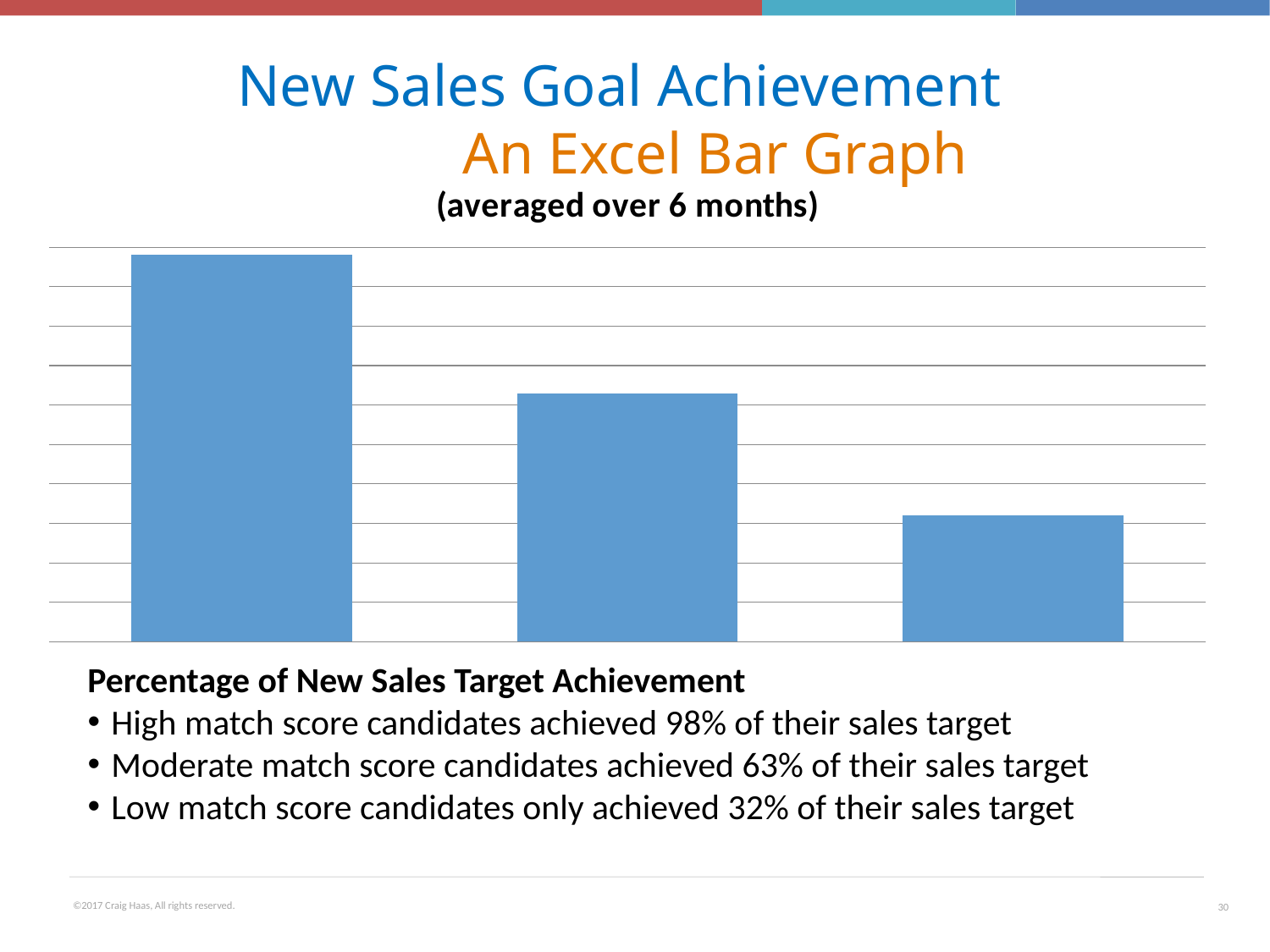
Over what period does the slide say the chart values are averaged? 6 months How many bars are plotted in the chart? 3 Which is taller, the left bar or the middle bar? the left bar According to the slide text, what percentage of their sales target did low match score candidates achieve? 32% What kind of chart is shown on the slide? bar chart Do the bar heights rise or fall from left to right across the chart? fall Which is taller, the middle bar or the right bar? the middle bar What is the main title shown above the chart? New Sales Goal Achievement According to the slide text, what percentage of their sales target did high match score candidates achieve? 98% Which bar is the shortest in the chart: the left, middle, or right one? right According to the slide text, what percentage of their sales target did moderate match score candidates achieve? 63% Which bar is the tallest in the chart: the left, middle, or right one? left